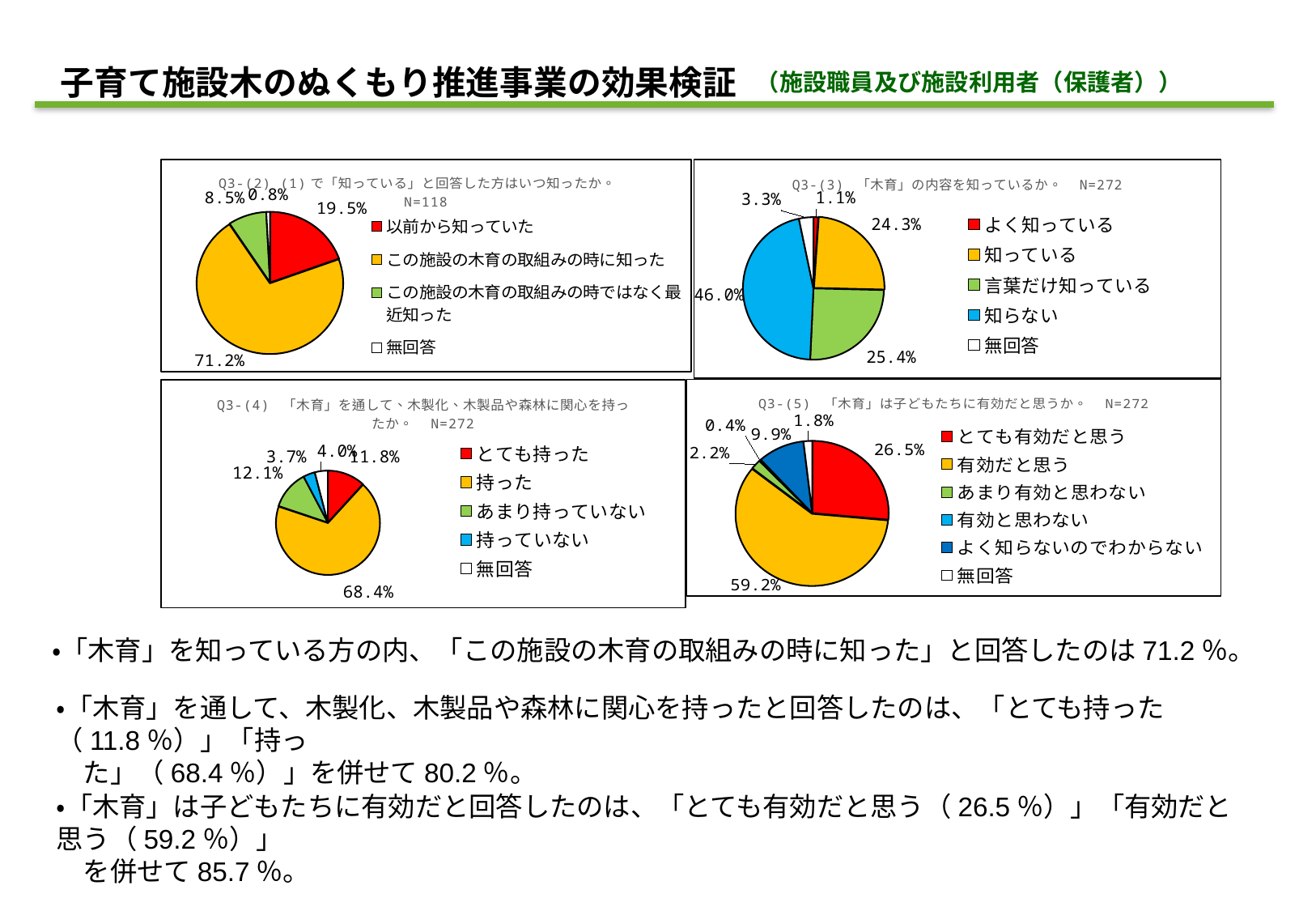
In the Q3-(5) pie chart (bottom right), what percentage is shown for 「よく知らないのでわからない」? 9.9% In the Q3-(4) pie chart (bottom left), which is larger: 「あまり持っていない」 or 「とても持った」? あまり持っていない In the Q3-(5) pie chart (bottom right), what is the combined share of 「とても有効だと思う」 and 「有効だと思う」? 85.7% What type of chart is used for Q3-(3) (top right)? Pie chart In the Q3-(3) pie chart (top right), which category has the largest share? 知らない How many categories does the legend of the Q3-(5) pie chart (bottom right) list? 6 In the Q3-(5) pie chart (bottom right), which category has the smallest share? 有効と思わない In the Q3-(3) pie chart (top right), what percentage of respondents answered 「知らない」? 46.0% In the Q3-(2) pie chart (top left), what percentage is shown for 「この施設の木育の取組みの時に知った」? 71.2% In the Q3-(4) pie chart (bottom left), what percentage is shown for 「持った」? 68.4% What is the N value shown in the title of the Q3-(2) pie chart (top left)? N=118 In the Q3-(2) pie chart (top left), what is the difference between 「この施設の木育の取組みの時に知った」 and 「以前から知っていた」? 51.7%